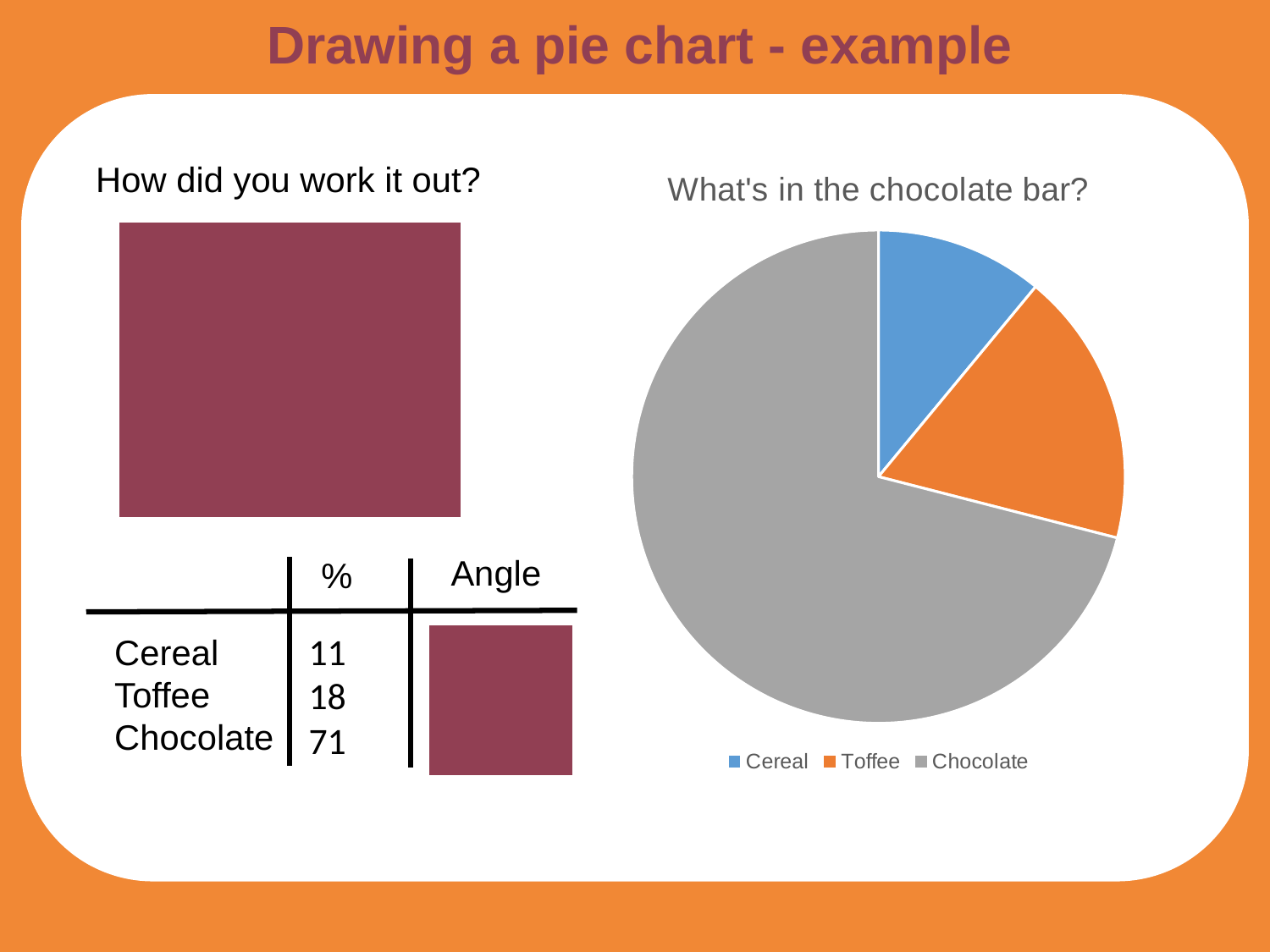
According to the table on the slide, what percentage of the chocolate bar is Toffee? 18 How many slices does the pie chart have? 3 Which slice of the pie chart is the smallest? Cereal What kind of chart is shown on the slide? pie chart Which slice is larger in the pie chart, Toffee or Cereal? Toffee What is the title of the pie chart? What's in the chocolate bar? Which slice of the pie chart is the largest? Chocolate Which slice is larger in the pie chart, Chocolate or Toffee? Chocolate How many entries does the pie chart's legend list? 3 What colour is the Chocolate slice in the pie chart? grey According to the table on the slide, what percentage of the chocolate bar is Chocolate? 71 According to the table on the slide, what percentage of the chocolate bar is Cereal? 11